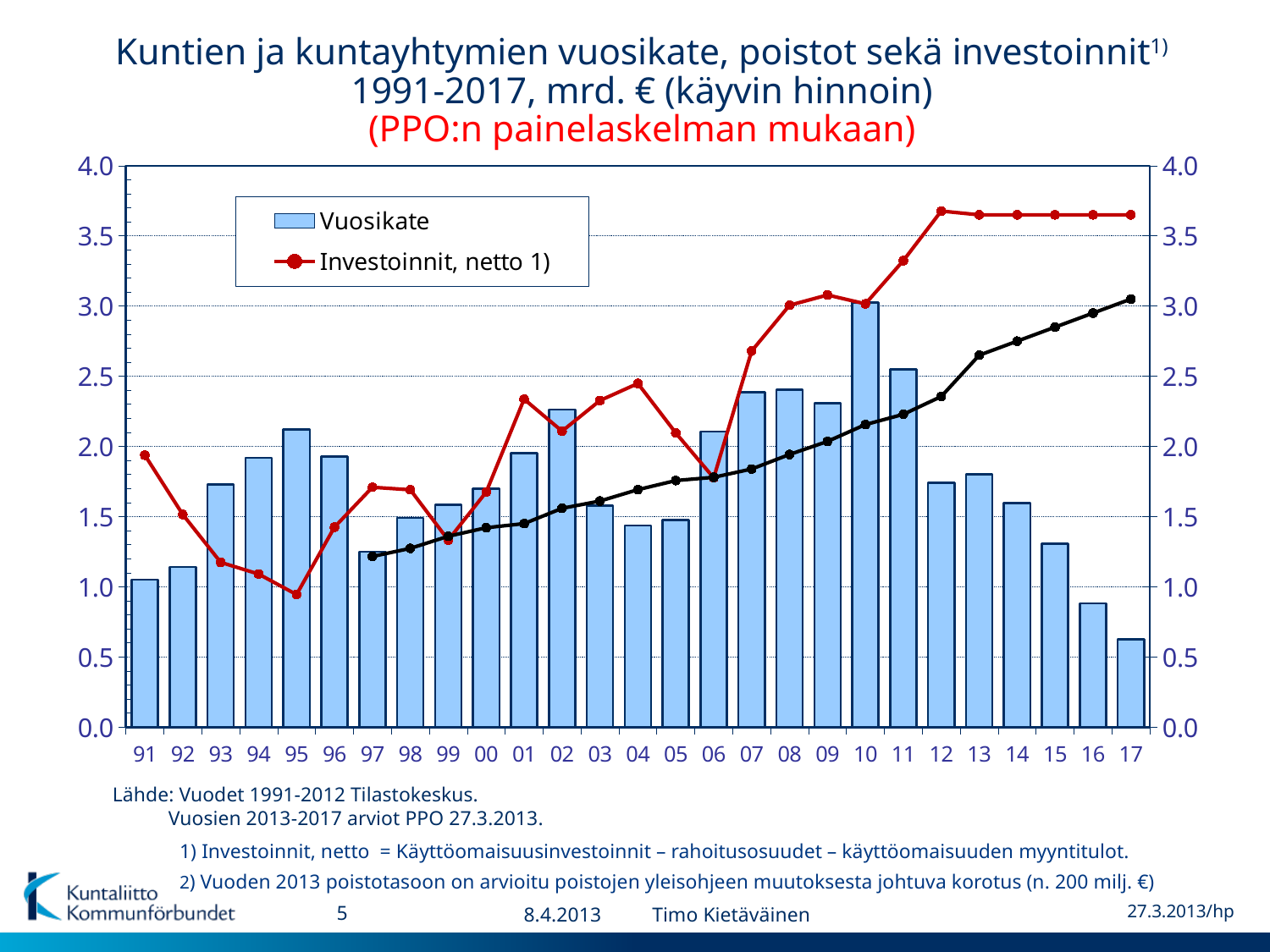
Is the Vuosikate value for 17 greater or less than 1.0? less What kind of chart is shown on the slide? A combined bar and line chart In which year is the Vuosikate bar the highest? 10 Which series are listed in the chart legend? Vuosikate and Investoinnit, netto 1) Which is larger, the Vuosikate bar for 02 or the Vuosikate bar for 03? 02 Is the Investoinnit, netto value for 12 greater or less than 3.5? greater Is the Vuosikate value for 08 greater or less than 2.0? greater How many series does the chart legend list? 2 Does the black line rise or fall from 97 to 17? rises In which year is the Vuosikate bar the lowest? 17 How many years are shown on the x axis of the chart? 27